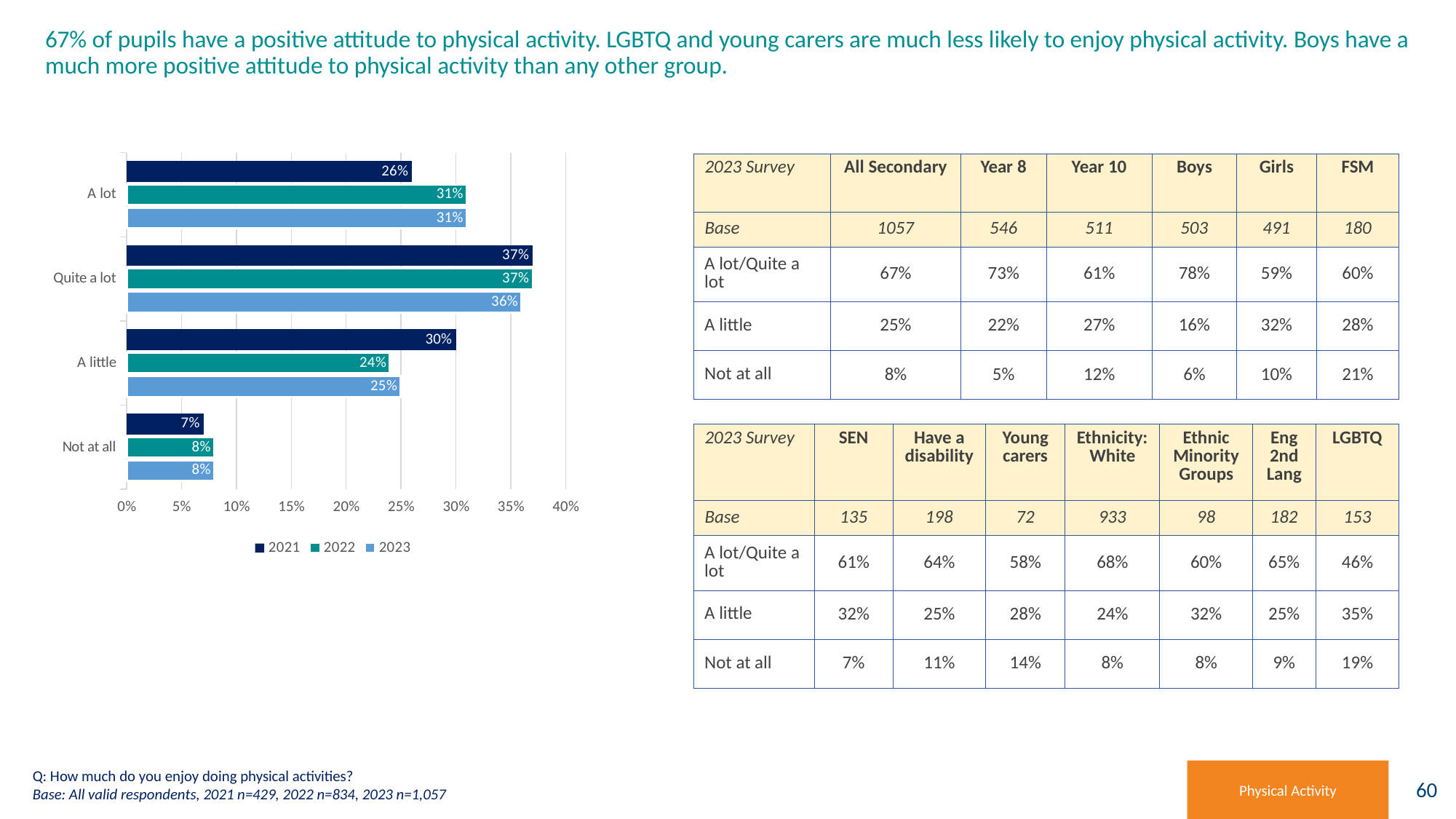
Which category has the highest value for 2023? Quite a lot What is the value for 'A little' in 2022? 24% What is the value for 'Quite a lot' in 2023? 36% Which category has the lowest value for 2021? Not at all Which series is shown in the darkest blue colour? 2021 What is the value for 'A lot' in 2021? 26% What kind of chart is shown on the slide? Bar chart What is the difference between the 2022 and 2021 values for 'A lot'? 5% How many categories are shown on the chart? 4 What is the value for 'Not at all' in 2021? 7% Which is larger: the 2021 value for 'A little' or the 2023 value for 'A little'? 2021 How many series does the legend list? 3